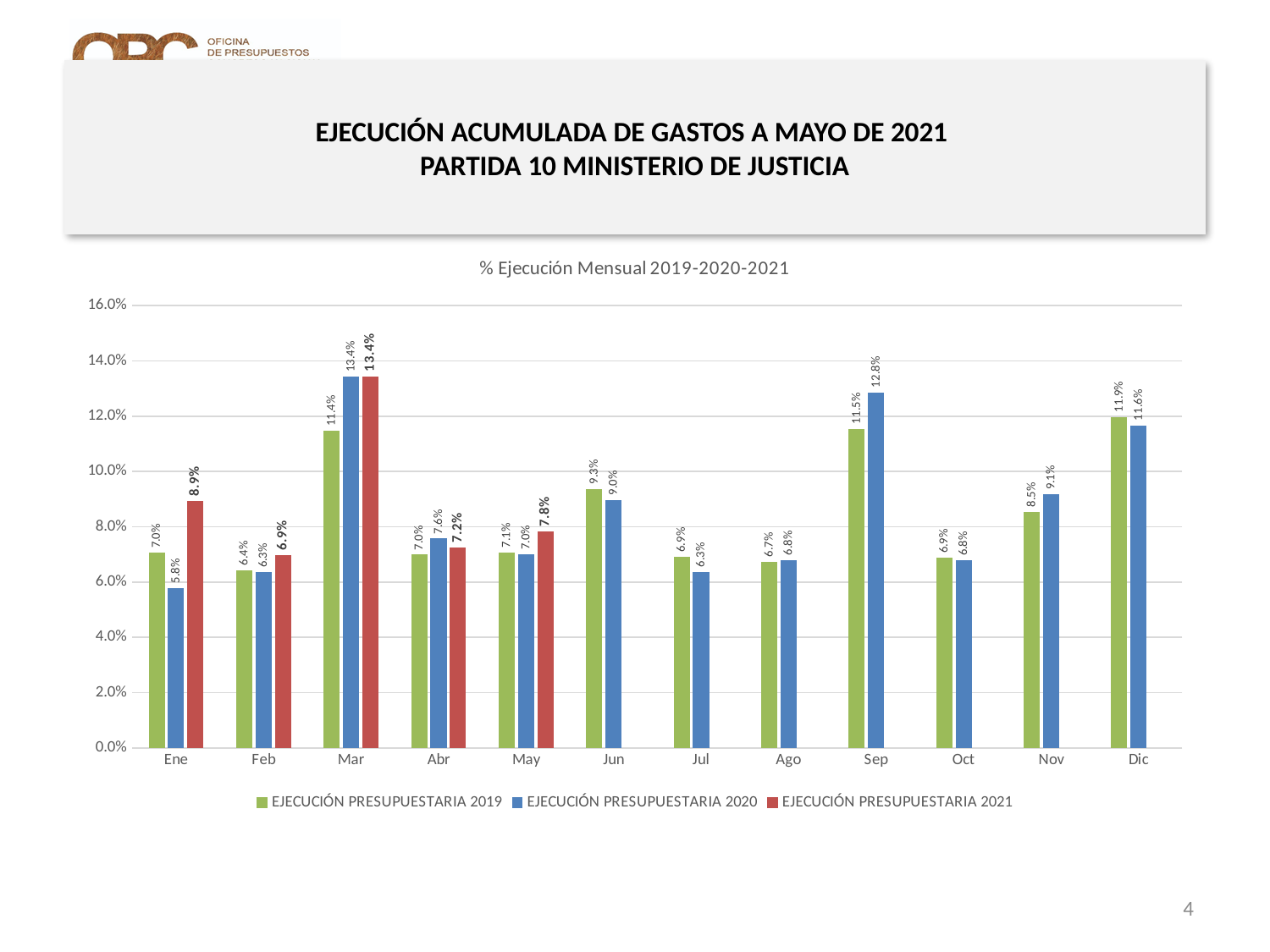
What is the title of the chart? % Ejecución Mensual 2019-2020-2021 Which is larger in Sep: EJECUCIÓN PRESUPUESTARIA 2019 or EJECUCIÓN PRESUPUESTARIA 2020? EJECUCIÓN PRESUPUESTARIA 2020 What is the value for EJECUCIÓN PRESUPUESTARIA 2021 in Ene? 8.9% What is the value for EJECUCIÓN PRESUPUESTARIA 2020 in Sep? 12.8% How many months are shown on the x axis? 12 Is the value for EJECUCIÓN PRESUPUESTARIA 2019 in Mar greater or less than 10.0%? greater What is the difference between the EJECUCIÓN PRESUPUESTARIA 2021 and EJECUCIÓN PRESUPUESTARIA 2019 values in Ene? 1.9% What kind of chart is shown on the slide? Bar chart In which month is the EJECUCIÓN PRESUPUESTARIA 2020 series lowest? Ene In which month is the EJECUCIÓN PRESUPUESTARIA 2021 series highest? Mar How many series does the legend list? 3 What is the value for EJECUCIÓN PRESUPUESTARIA 2019 in Dic? 11.9%